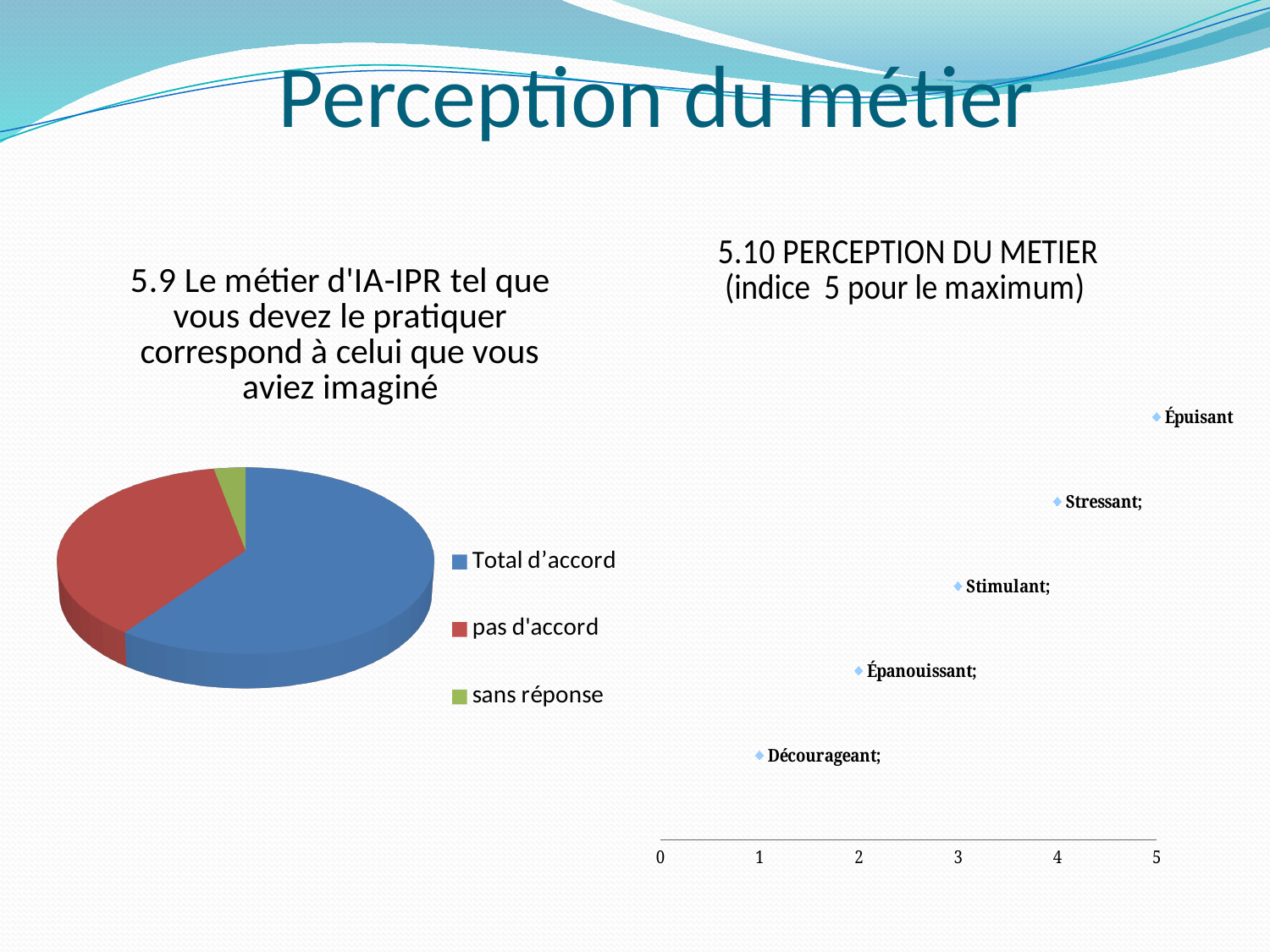
On the pie chart on the left, what colour is the slice for pas d'accord? Red On the pie chart on the left, which category has the smallest slice? sans réponse On the chart titled "5.10 PERCEPTION DU METIER", which has the larger value: Stressant or Stimulant? Stressant On the chart titled "5.10 PERCEPTION DU METIER", which item has the highest value? Épuisant On the chart titled "5.10 PERCEPTION DU METIER", is the value for Décourageant greater or less than 2? less On the chart titled "5.10 PERCEPTION DU METIER", is the value for Épuisant greater or less than 4? greater On the pie chart on the left, which slice is larger: Total d'accord or pas d'accord? Total d'accord On the chart titled "5.10 PERCEPTION DU METIER", which item has the lowest value? Décourageant On the chart titled "5.9 Le métier d'IA-IPR tel que vous devez le pratiquer correspond à celui que vous aviez imaginé", what kind of chart is shown? Pie chart On the pie chart on the left, which category has the largest slice? Total d'accord On the chart titled "5.10 PERCEPTION DU METIER", how many labelled points are plotted? 5 On the pie chart on the left, how many categories does the legend list? 3